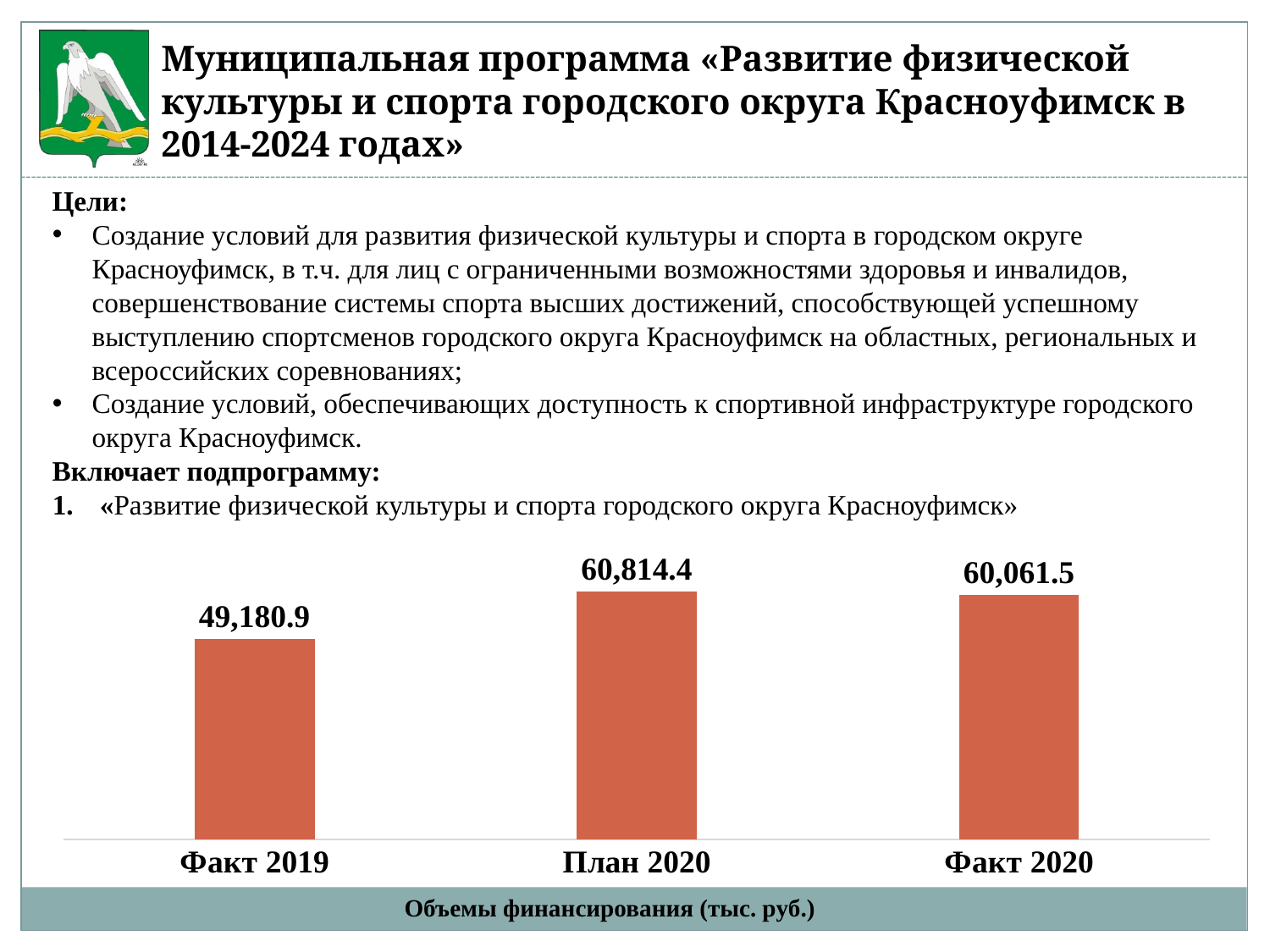
What is the value for План 2020 in the chart? 60,814.4 Which is larger, the value for Факт 2019 or the value for Факт 2020? Факт 2020 Which category has the highest value in the chart? План 2020 What is the title of the chart on the slide? Объемы финансирования (тыс. руб.) What is the value for Факт 2019 in the chart «Объемы финансирования (тыс. руб.)»? 49,180.9 What is the difference between the values for План 2020 and Факт 2019? 11,633.5 What kind of chart is shown on the slide? Bar chart Which category has the lowest value in the chart? Факт 2019 What is the difference between the values for Факт 2020 and Факт 2019? 10,880.6 What is the value for Факт 2020 in the chart? 60,061.5 How many categories are shown in the chart? 3 What is the difference between the values for План 2020 and Факт 2020? 752.9